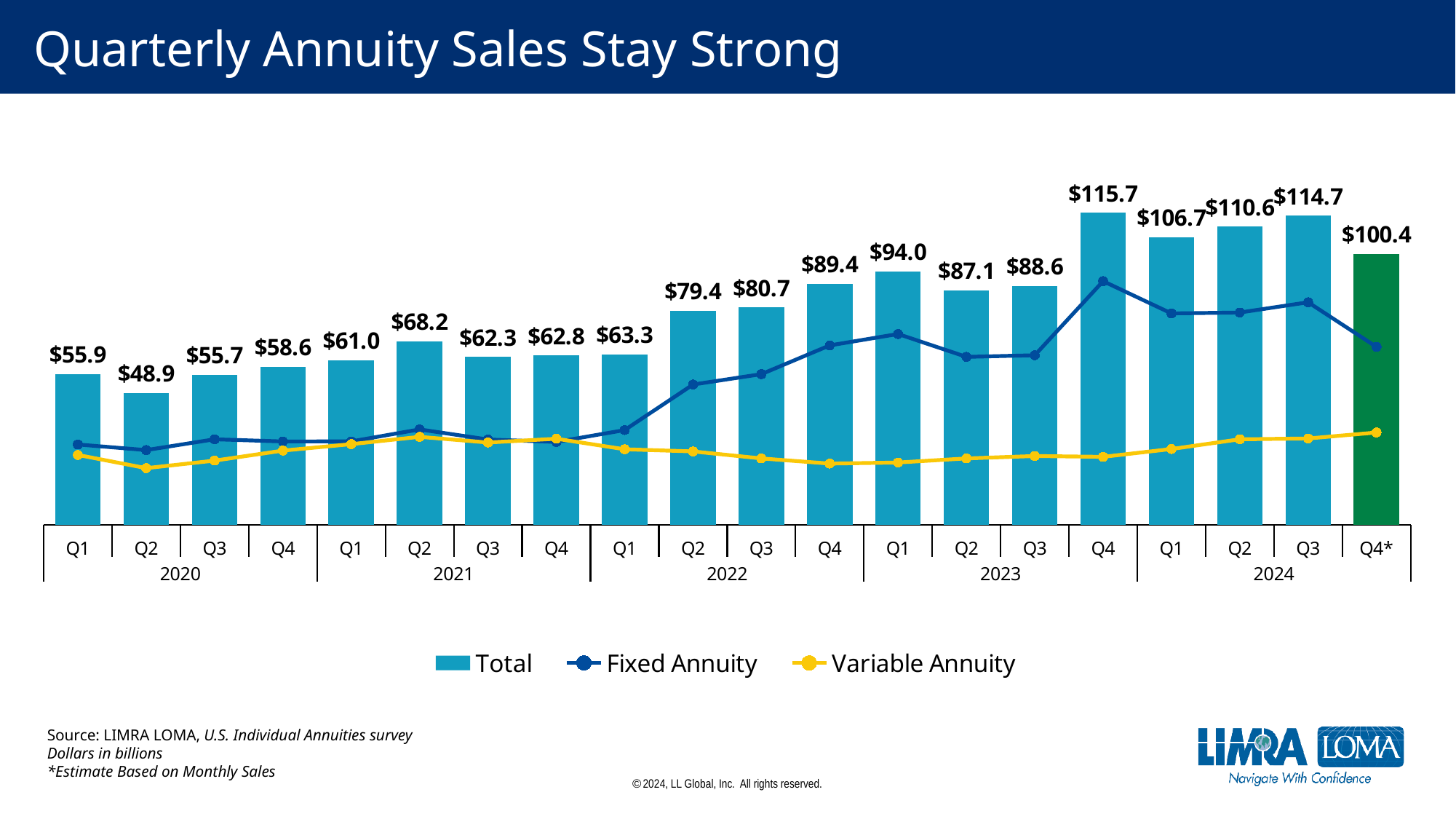
How many quarters are plotted on the chart? 20 What kind of chart is used to show the Total series? Bar chart What is the Total annuity sales value for Q4 2023? $115.7 Which quarter has the lowest Total annuity sales? Q2 2020 Do Total annuity sales generally rise or fall from Q1 2020 to Q4 2023? Rise What is the difference between Total sales in Q3 2024 and Q1 2024? $8.0 Which series is shown with a yellow line? Variable Annuity Which quarter has the highest Total annuity sales? Q4 2023 Which is larger, Total sales in Q1 2023 or Q3 2023? Q1 2023 How many series does the legend list? 3 What is the estimated Total annuity sales value for Q4* 2024? $100.4 What is the Total annuity sales value for Q2 2020? $48.9